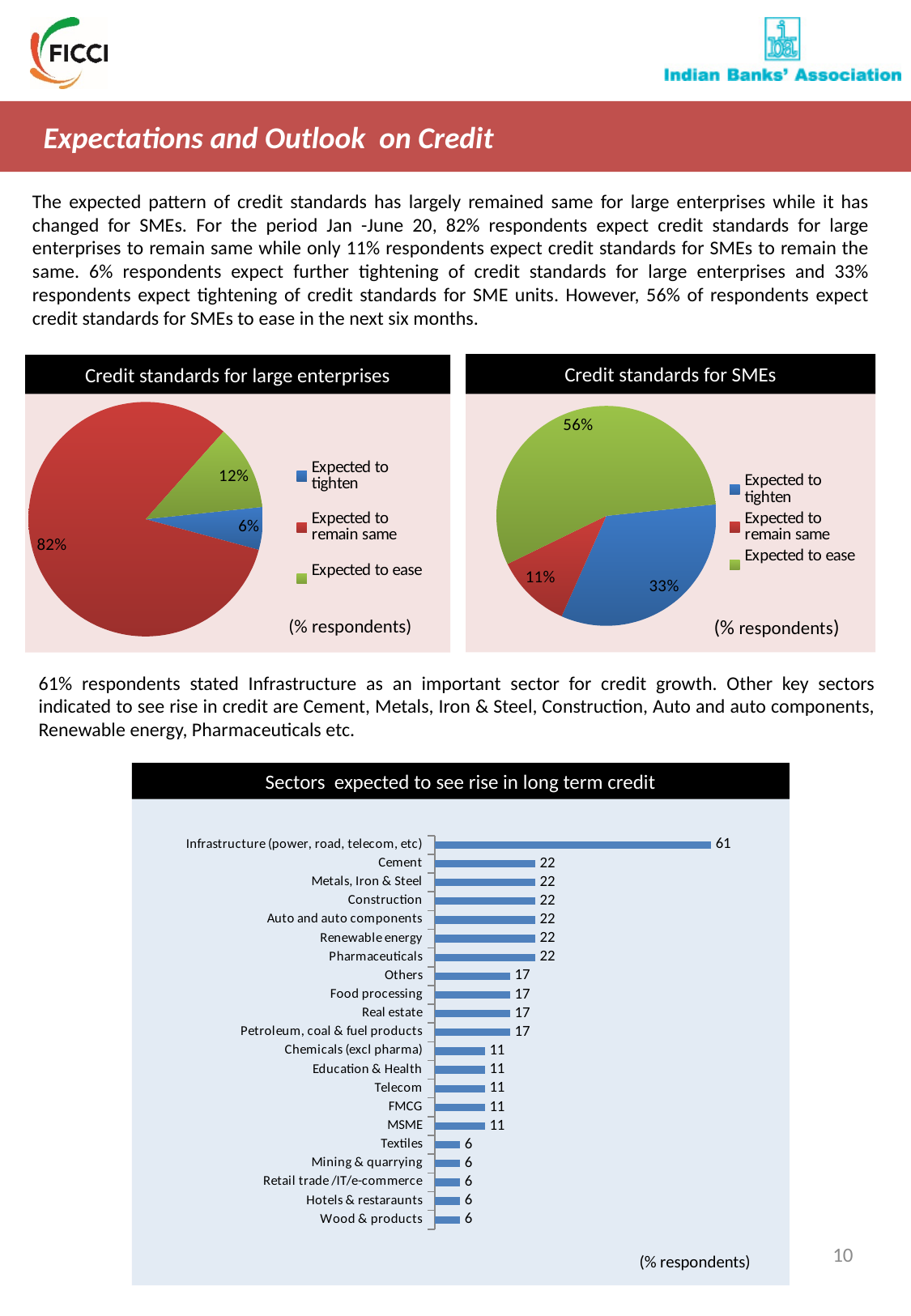
How many entries does the legend of the 'Credit standards for SMEs' chart list? 3 In the 'Credit standards for SMEs' chart, what percentage of respondents expect credit standards to ease? 56% What kind of chart is 'Sectors expected to see rise in long term credit'? Bar chart In the 'Credit standards for large enterprises' chart, what percentage of respondents expect credit standards to remain the same? 82% In the 'Sectors expected to see rise in long term credit' chart, what is the value for Real estate? 17 In the 'Sectors expected to see rise in long term credit' chart, what is the difference between the values for Infrastructure (power, road, telecom, etc) and Cement? 39 In the 'Sectors expected to see rise in long term credit' chart, what is the value for Infrastructure (power, road, telecom, etc)? 61 In the 'Credit standards for SMEs' chart, which category has the smallest share? Expected to remain same In the 'Credit standards for SMEs' chart, what is the difference between the share expecting tightening and the share expecting credit standards to remain the same? 22% In the 'Sectors expected to see rise in long term credit' chart, how many sectors are listed? 21 What kind of chart is 'Credit standards for large enterprises'? Pie chart In the 'Credit standards for large enterprises' chart, which category has the largest share? Expected to remain same